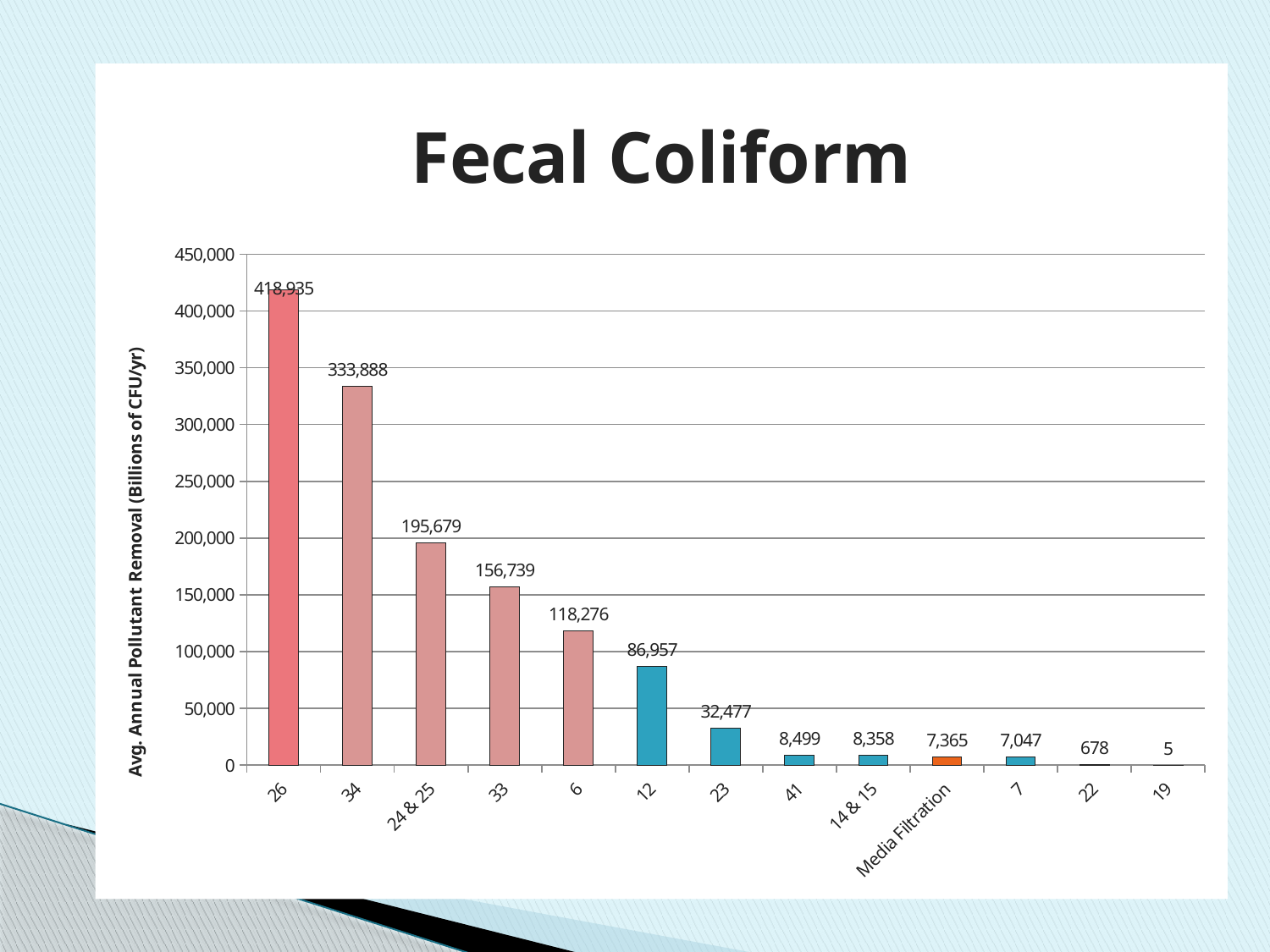
Which category has the highest value? 26 What is the value for category 26? 418,935 What kind of chart is shown on the slide? bar chart What is the value for Media Filtration? 7,365 Is the value for category 23 greater or less than 50,000? less What is the value for category 12? 86,957 How many categories are shown on the x axis? 13 Which is larger, the value for category 33 or the value for category 6? 33 What is the label of the vertical axis? Avg. Annual Pollutant Removal (Billions of CFU/yr) What is the difference between the values for category 26 and category 34? 85,047 What is the value for category 24 & 25? 195,679 Which category has the lowest value? 19